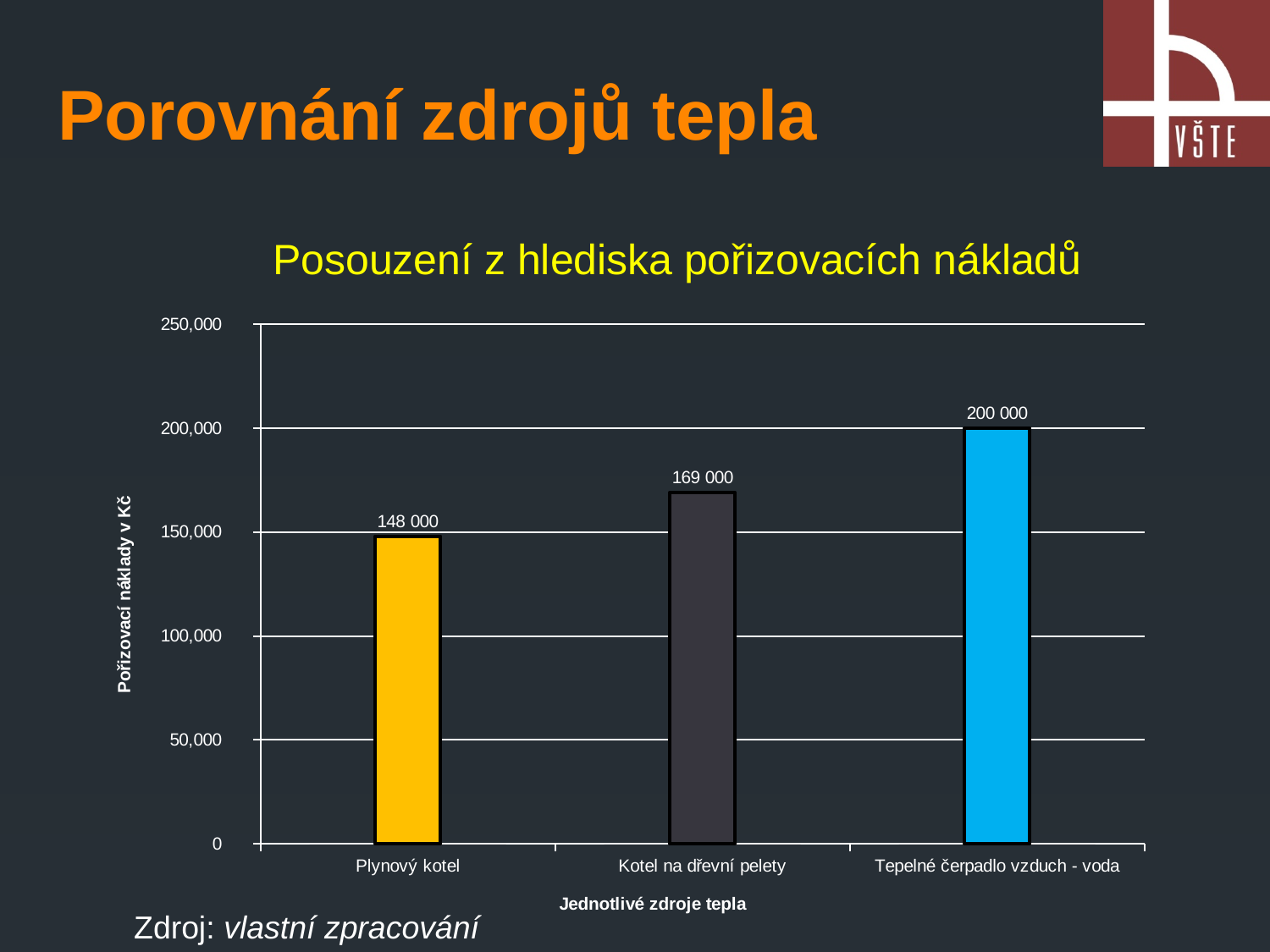
Is the value for Kotel na dřevní pelety greater or less than 150,000? greater Which category has the lowest value? Plynový kotel What is the value for Kotel na dřevní pelety? 169 000 What is the difference between the values for Tepelné čerpadlo vzduch - voda and Plynový kotel? 52 000 What is the difference between the values for Kotel na dřevní pelety and Plynový kotel? 21 000 Which category has the highest value? Tepelné čerpadlo vzduch - voda What kind of chart is shown on the slide? bar chart What is the value for Tepelné čerpadlo vzduch - voda? 200 000 Which is larger, the value for Kotel na dřevní pelety or the value for Plynový kotel? Kotel na dřevní pelety What is the title of the chart? Posouzení z hlediska pořizovacích nákladů What is the value for Plynový kotel? 148 000 How many categories are shown on the x axis? 3